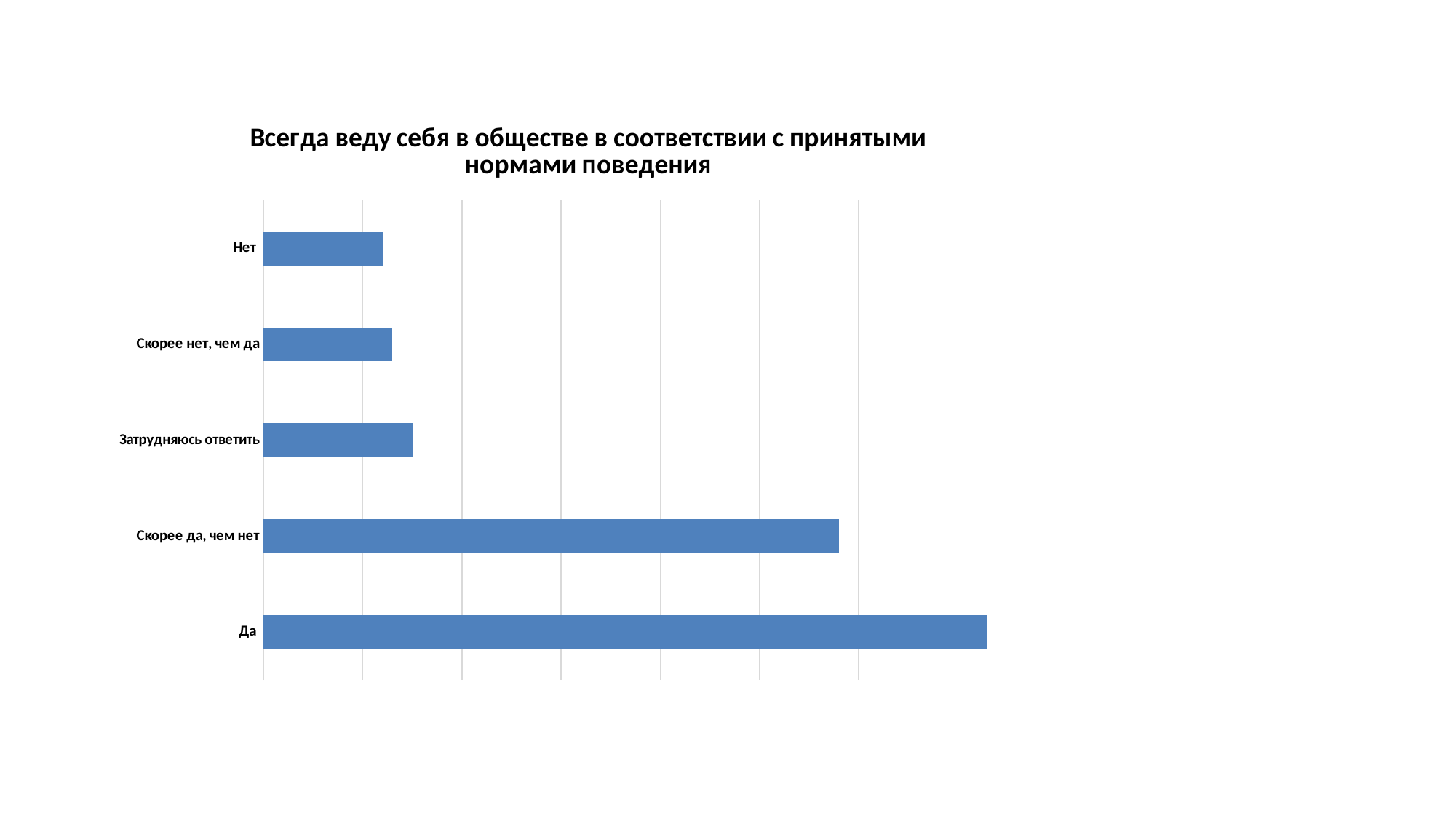
Which category is listed at the top of the chart? Нет What kind of chart is shown on the slide? bar chart Which is larger, the value for "Затрудняюсь ответить" or the value for "Нет"? Затрудняюсь ответить How many categories are plotted in the chart? 5 What is the title of the chart? Всегда веду себя в обществе в соответствии с принятыми нормами поведения Which category has the lowest value? Нет Which is larger, the value for "Скорее да, чем нет" or the value for "Скорее нет, чем да"? Скорее да, чем нет Which category has the highest value? Да Which is larger, the value for "Затрудняюсь ответить" or the value for "Скорее нет, чем да"? Затрудняюсь ответить